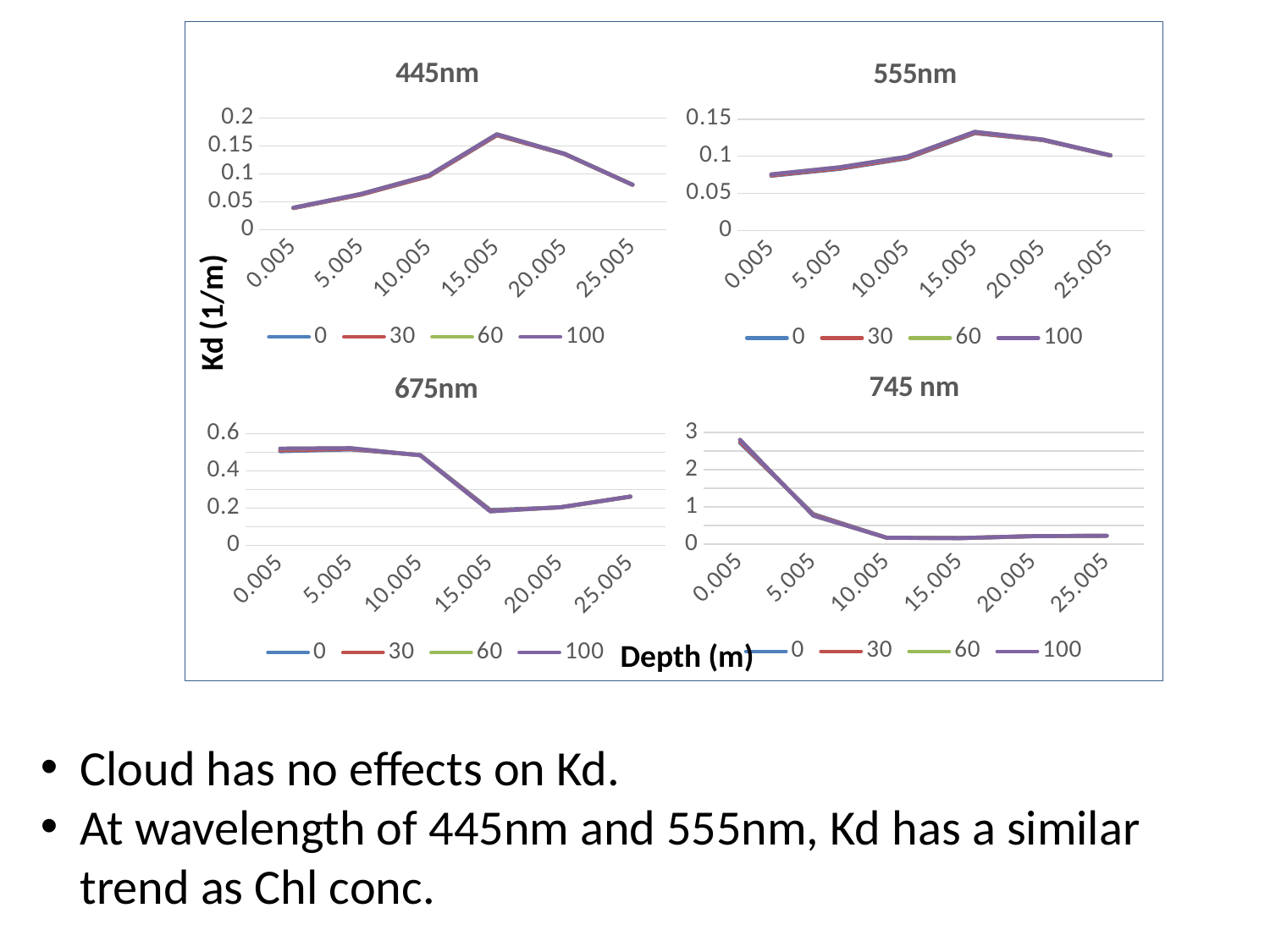
In the 445nm chart, at which depth is Kd highest? 15.005 In the 445nm chart, do the values rise or fall from 0.005 to 15.005? rise In the 745 nm chart, is the value at 0.005 greater or less than 2? greater How many depth points are plotted along the x axis of the 675nm chart? 6 How many series does the legend of the 555nm chart list? 4 In the 555nm chart, is the value at 0.005 greater or less than 0.05? greater In the 675nm chart, is the value at 15.005 greater or less than 0.4? less What type of chart is the 445nm chart? line chart In the 745 nm chart, do the values rise or fall from 0.005 to 10.005? fall What is the y-axis label shared by the charts? Kd (1/m) In the 745 nm chart, at which depth is Kd highest? 0.005